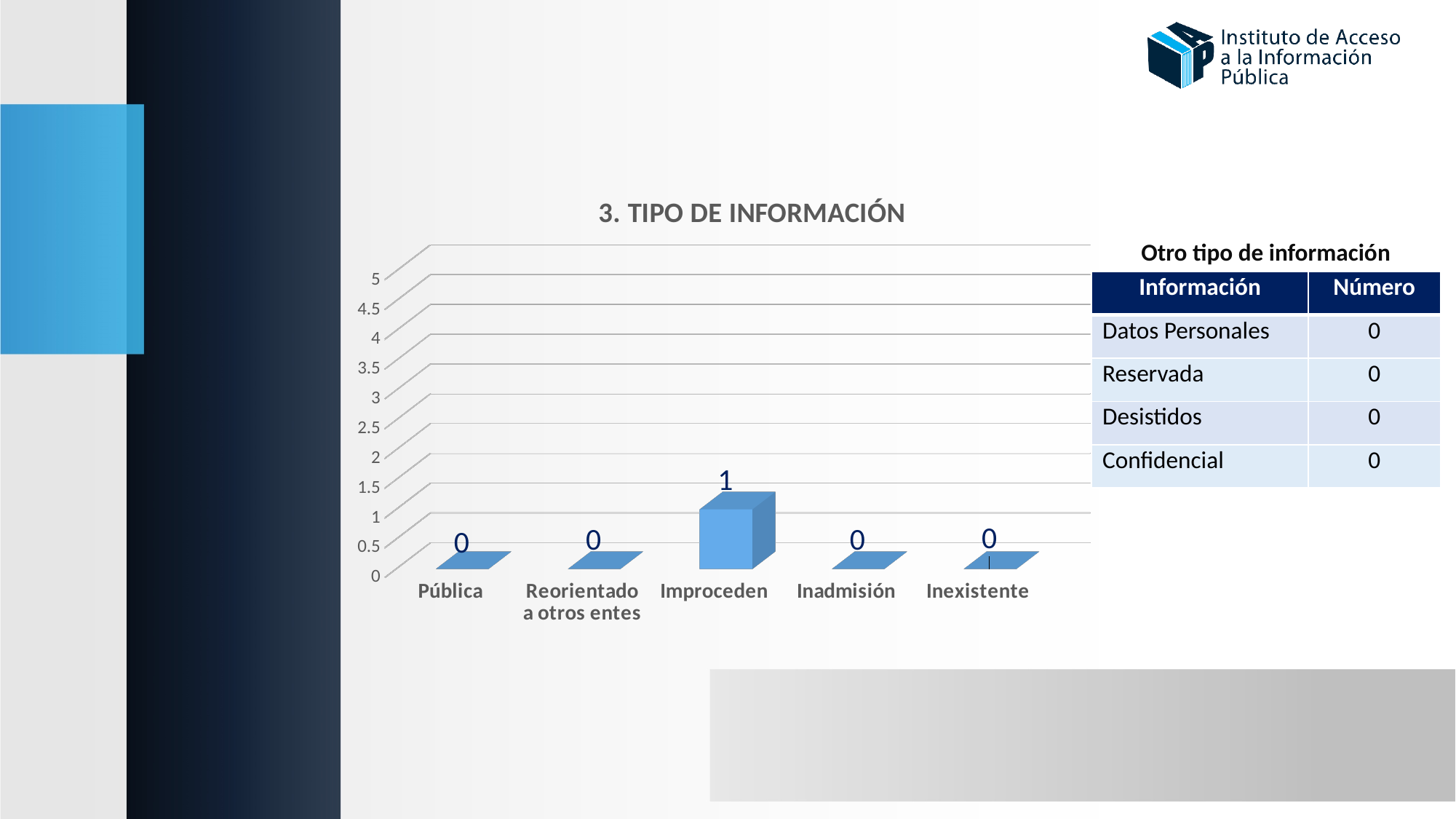
What is the value for Reorientado a otros entes in the chart? 0 What is the highest value shown on the vertical axis of the chart? 5 How many categories are shown on the x axis of the chart? 5 Which is larger, the value for Improceden or the value for Pública? Improceden What kind of chart is shown on the slide? bar chart What is the difference between the values for Improceden and Inadmisión? 1 What is the value for Improceden in the chart? 1 What is the value for Inexistente in the chart? 0 What is the value for Pública in the chart? 0 What is the title of the chart? 3. TIPO DE INFORMACIÓN Is the value for Improceden greater or less than 3? less Which category has the highest value in the chart? Improceden